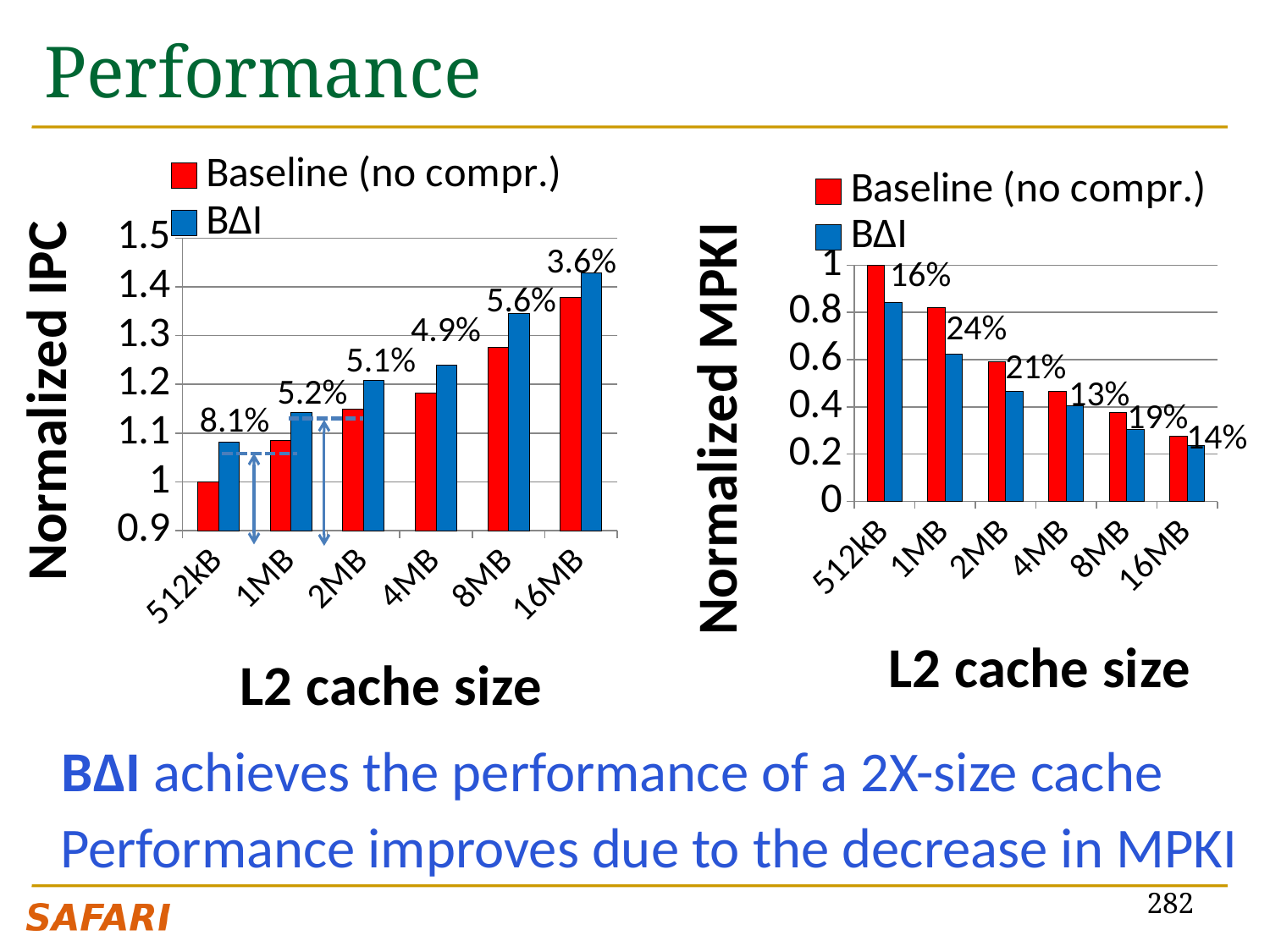
How many series does the legend of the Normalized MPKI chart on the right list? 2 In the Normalized MPKI chart on the right, do the Baseline (no compr.) values rise or fall as L2 cache size increases? fall In the Normalized MPKI chart on the right, which L2 cache size has the lowest percentage label? 4MB In the Normalized MPKI chart on the right, is the Baseline (no compr.) value at 16MB greater or less than 0.2? greater In the Normalized IPC chart on the left, which L2 cache size has the highest percentage label? 512kB How many L2 cache sizes are shown on the x axis of the Normalized IPC chart on the left? 6 In the Normalized MPKI chart on the right, what percentage label is shown for 1MB? 24% What kind of chart is the Normalized IPC chart on the left? bar chart In the Normalized IPC chart on the left, what percentage label is shown above the 512kB bars? 8.1% In the Normalized IPC chart on the left, what is the Baseline (no compr.) value at 512kB? 1 In the Normalized IPC chart on the left, which series is higher at 4MB, Baseline (no compr.) or BΔI? BΔI In the Normalized IPC chart on the left, is the BΔI value at 16MB greater or less than 1.4? greater